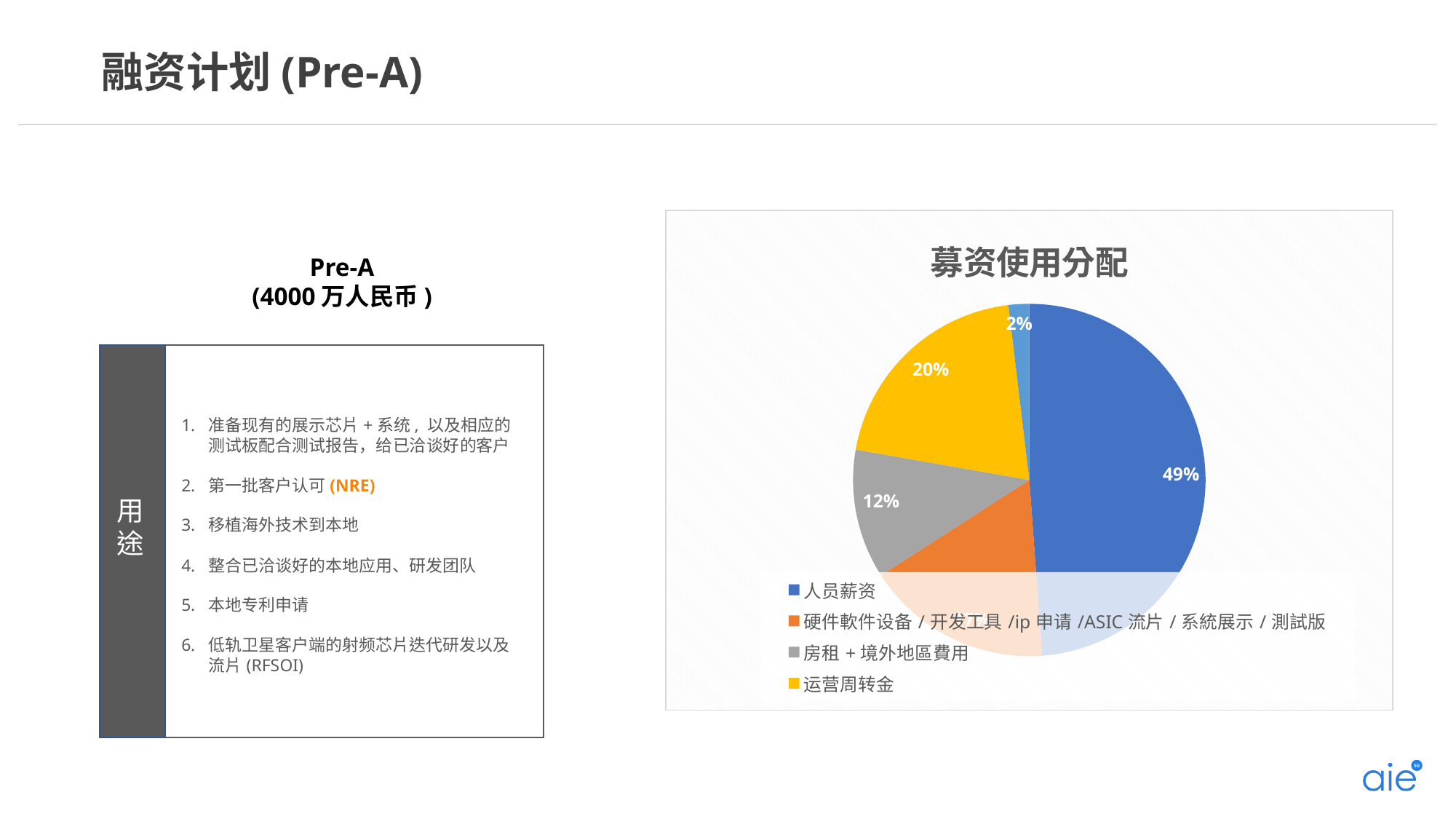
What colour is the 人员薪资 slice in the pie chart? blue What percentage is shown for 房租 + 境外地區費用 in the pie chart? 12% What share of the pie chart does 运营周转金 take? 20% What is the title of the pie chart? 募资使用分配 How many entries does the legend of the pie chart list? 4 What is the difference between the 运营周转金 share and the 房租 + 境外地區費用 share in the pie chart? 8 percentage points What kind of chart is shown under the title 募资使用分配? pie chart Which slice is larger in the pie chart, 运营周转金 or 房租 + 境外地區費用? 运营周转金 What percentage of the pie chart is allocated to 人员薪资? 49% What is the smallest percentage label printed on the pie chart? 2% By how many percentage points does the 人员薪资 slice exceed the 运营周转金 slice? 29 percentage points Which category has the largest slice in the pie chart? 人员薪资